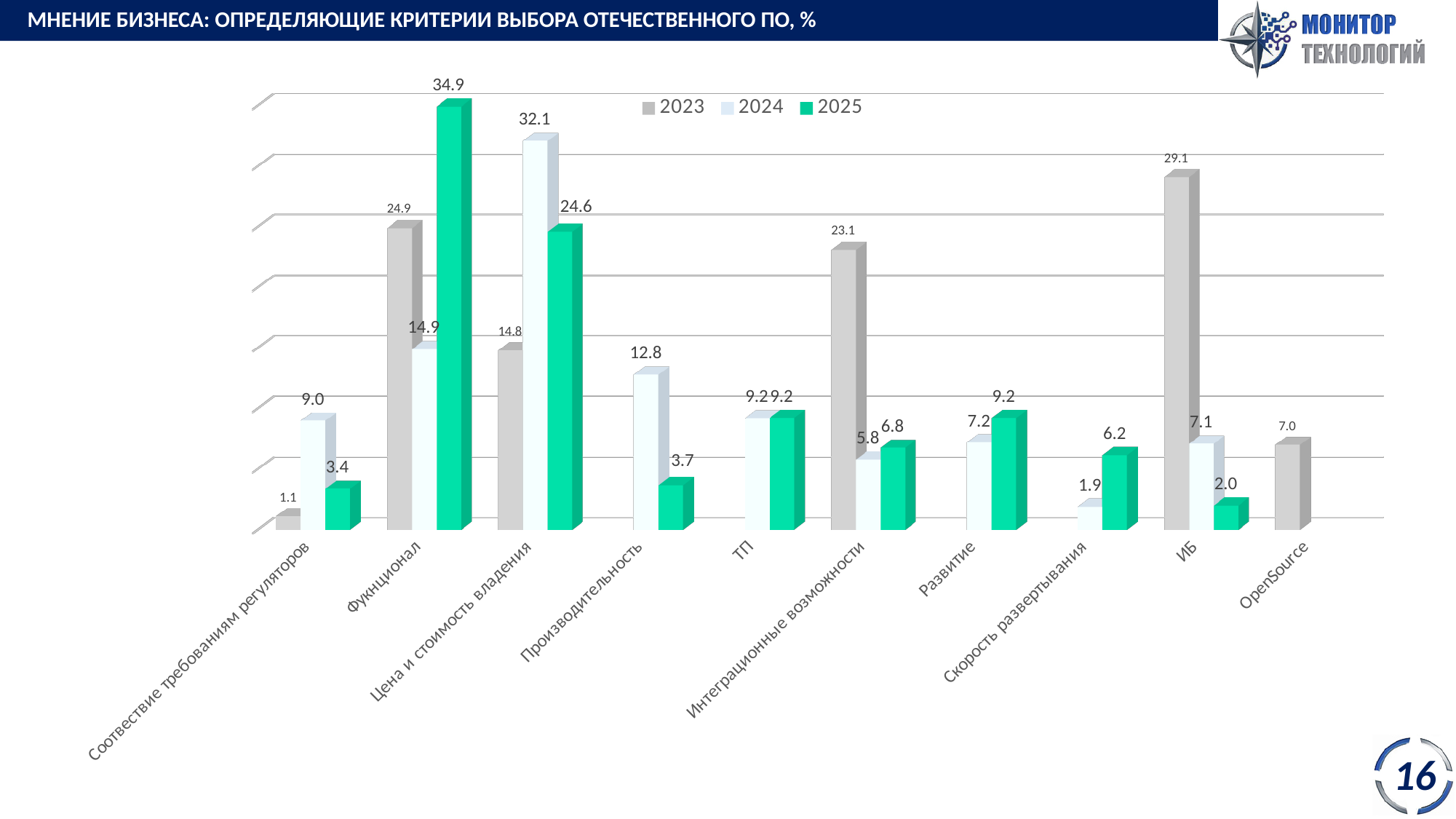
Which category has the highest 2023 value? ИБ How many series does the legend list? 3 What is the 2025 value for Скорость развертывания? 6.2 For Интеграционные возможности, which year has the larger value, 2023 or 2025? 2023 What is the 2023 value for ИБ? 29.1 What is the 2024 value for Цена и стоимость владения? 32.1 What kind of chart is shown on the slide? Bar chart Which category has the lowest 2024 value? Скорость развертывания What is the difference between the 2025 and 2023 values for Фукнционал? 10.0 What is the 2025 value for Фукнционал? 34.9 How many categories are shown on the x axis? 10 Which category has the highest 2025 value? Фукнционал